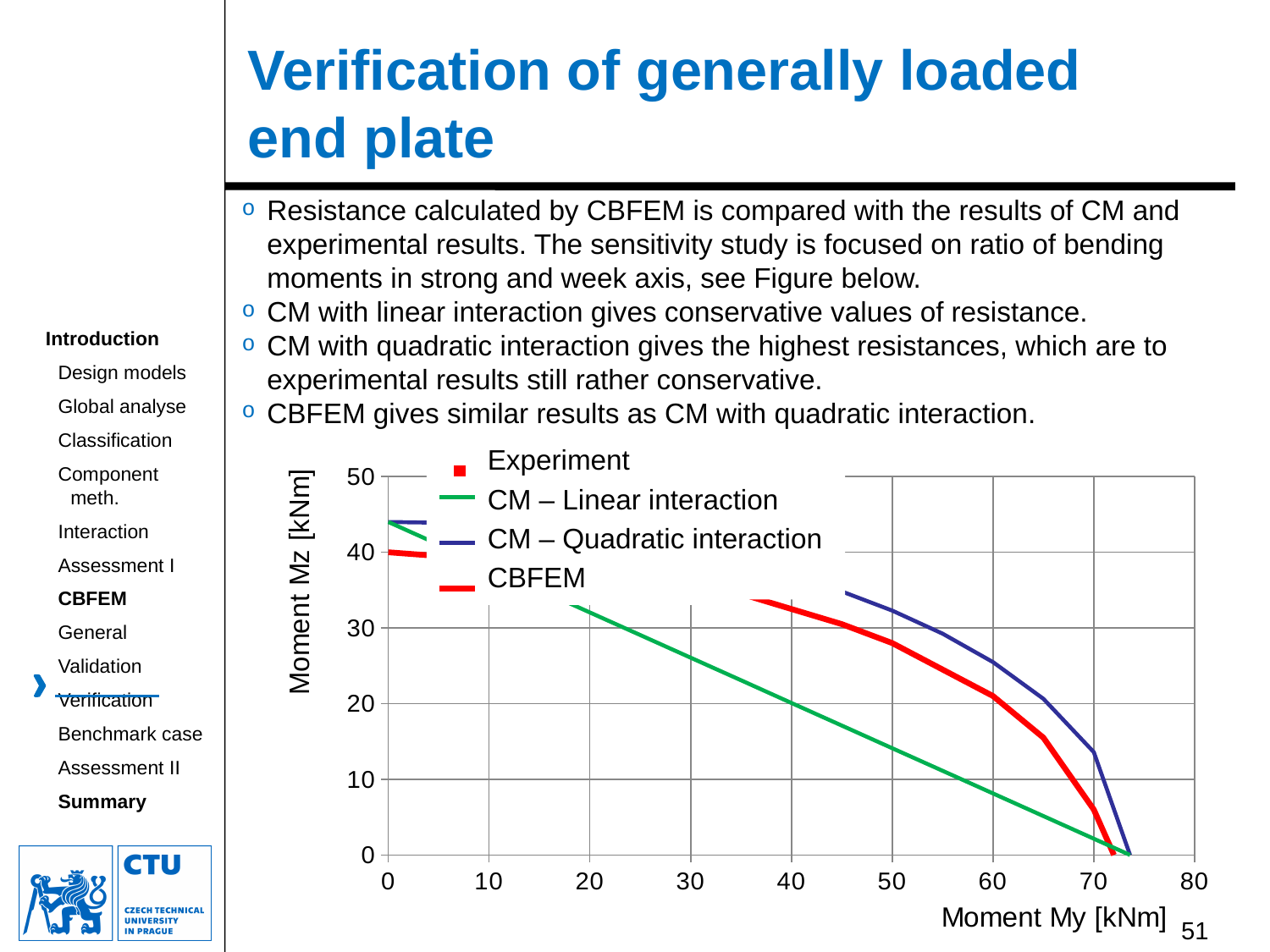
What is the highest value shown on the vertical axis of the chart? 50 What is the label of the vertical axis of the chart? Moment Mz [kNm] Is the Moment Mz value of the CBFEM series at Moment My = 50 greater or less than 20? greater Is the Moment Mz value of the CM – Linear interaction series at Moment My = 30 greater or less than 20? greater What is the highest value shown on the horizontal axis of the chart? 80 How many series does the chart legend list? 4 Is the Moment Mz value of the CM – Quadratic interaction series at Moment My = 60 greater or less than 20? greater At Moment My = 60, which series has the higher Moment Mz: CM – Linear interaction or CM – Quadratic interaction? CM – Quadratic interaction Do the Moment Mz values of the CM – Linear interaction series rise or fall as Moment My increases? fall What kind of chart is shown on the slide? line chart What is the label of the horizontal axis of the chart? Moment My [kNm]